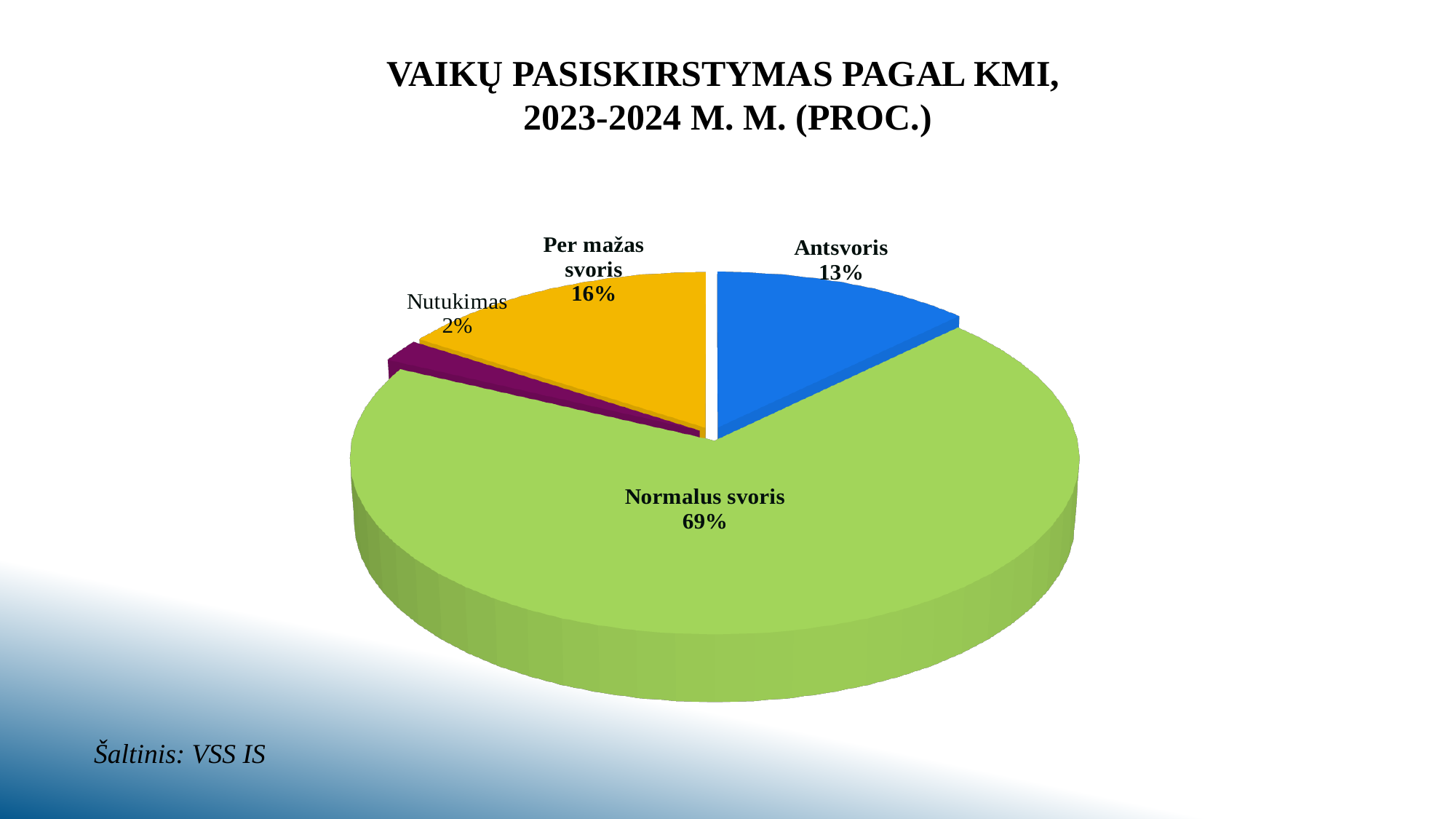
Which category has the largest share of the pie? Normalus svoris What is the difference between the values for Per mažas svoris and Antsvoris? 3% What is the value for Per mažas svoris? 16% How many categories are shown in the pie chart? 4 What is the title of the chart? VAIKŲ PASISKIRSTYMAS PAGAL KMI, 2023-2024 M. M. (PROC.) What kind of chart is shown on the slide? Pie chart What is the value for Nutukimas? 2% Which is larger, the value for Antsvoris or the value for Nutukimas? Antsvoris Which category has the smallest share of the pie? Nutukimas What is the value for Antsvoris? 13% What colour is the Antsvoris slice? Blue What is the value for Normalus svoris? 69%